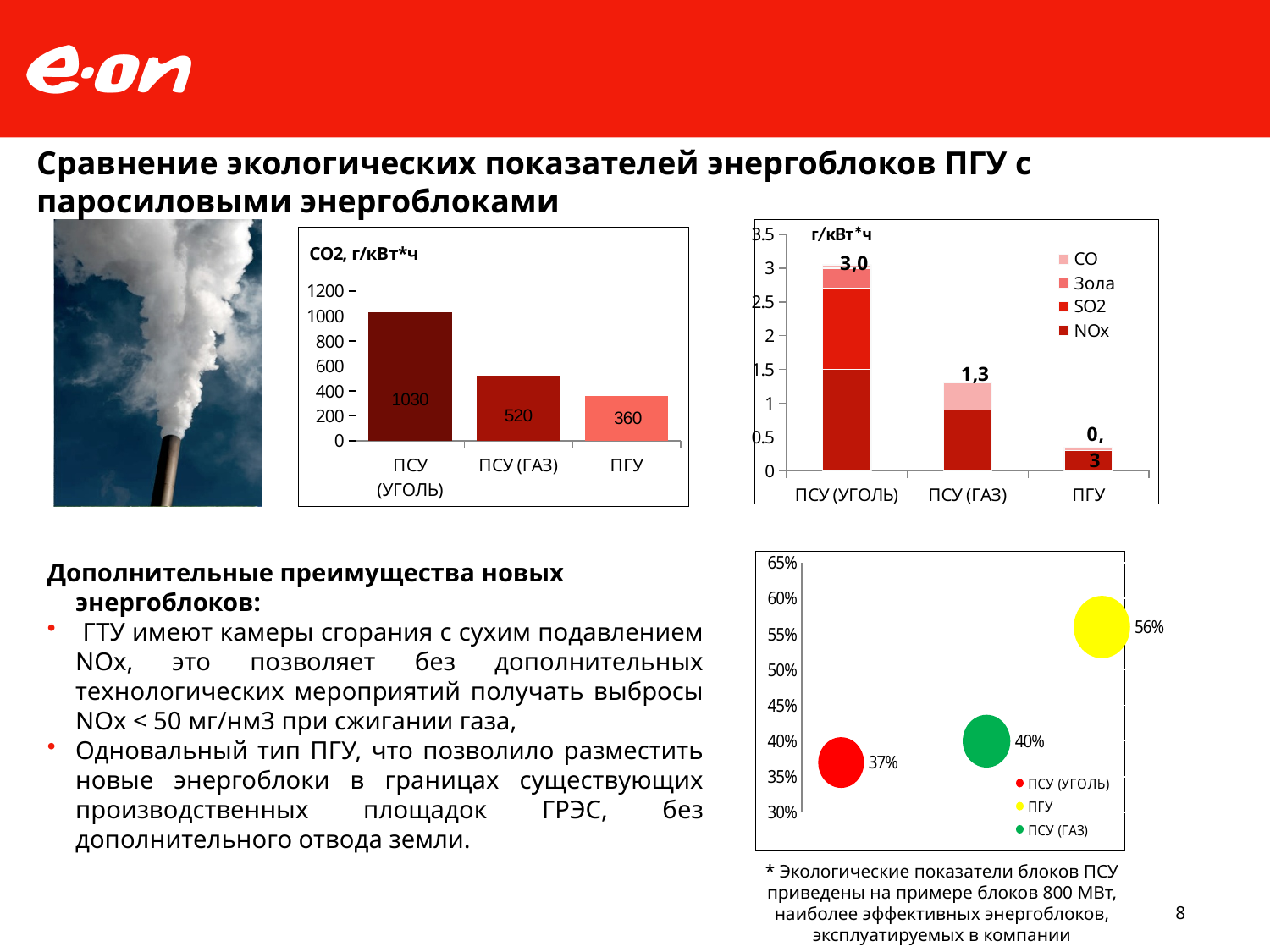
In the stacked г/кВт*ч chart at the top right, how many series does the legend list? 4 In the bubble chart at the bottom right, what is the difference between the ПГУ value and the ПСУ (УГОЛЬ) value? 19% In the stacked г/кВт*ч chart at the top right, is the NOx value for ПСУ (УГОЛЬ) greater or less than 1? greater In the stacked г/кВт*ч chart at the top right, which is larger, the total for ПСУ (ГАЗ) or the total for ПГУ? ПСУ (ГАЗ) In the bubble chart at the bottom right, what is the value for ПГУ? 56% In the CO2, г/кВт*ч chart, which category has the lowest value? ПГУ What kind of chart is the CO2, г/кВт*ч chart? bar chart In the CO2, г/кВт*ч chart, what is the value for ПСУ (УГОЛЬ)? 1030 In the CO2, г/кВт*ч chart, what is the value for ПГУ? 360 In the CO2, г/кВт*ч chart, do the values rise or fall from left to right along the x axis? fall In the stacked г/кВт*ч chart at the top right, what is the total for ПСУ (УГОЛЬ)? 3,0 In the CO2, г/кВт*ч chart, what is the difference between ПСУ (УГОЛЬ) and ПСУ (ГАЗ)? 510